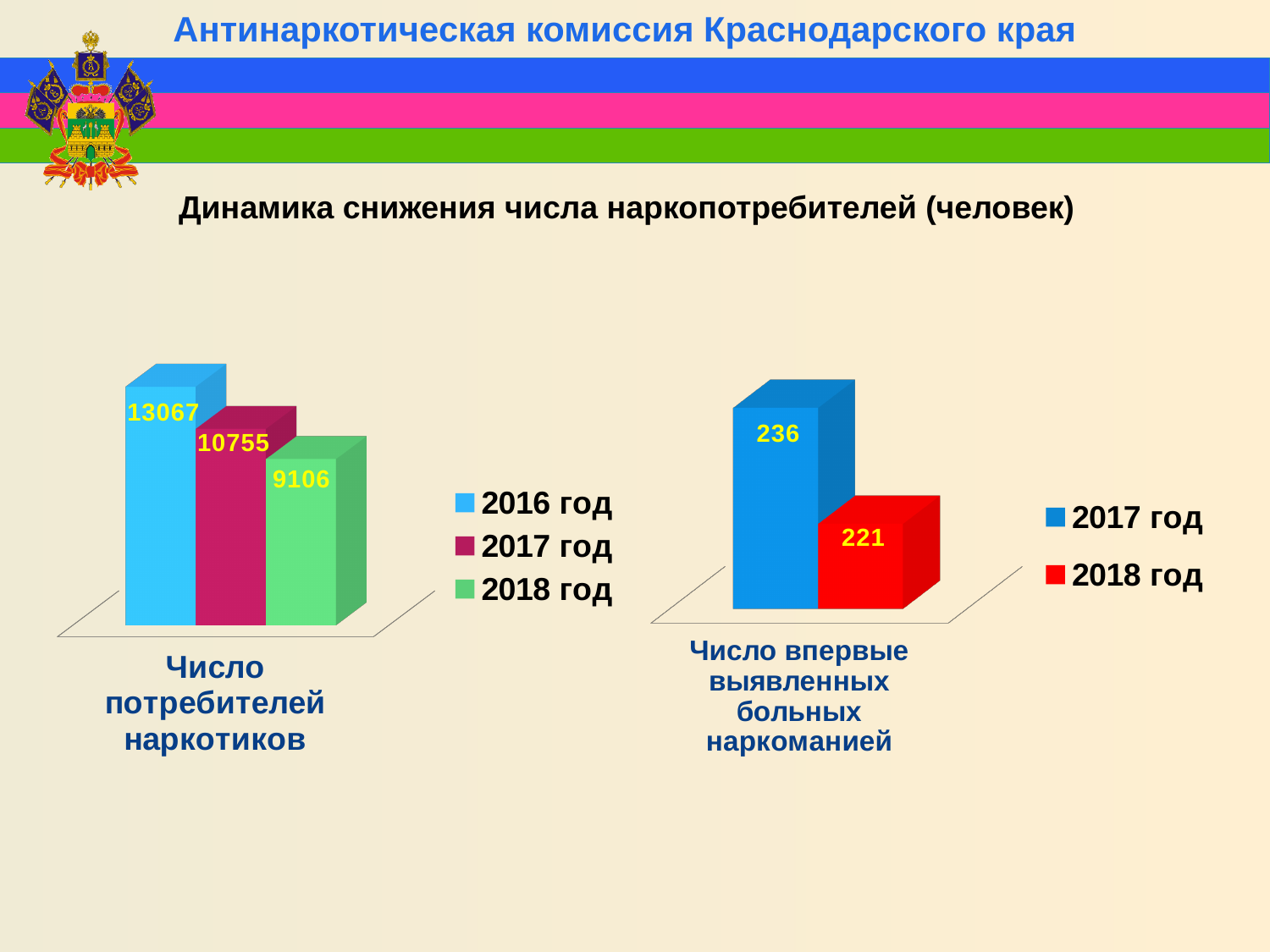
In the right chart (Число впервые выявленных больных наркоманией), what is the value for 2018 год? 221 What kind of chart is the right chart (Число впервые выявленных больных наркоманией)? Bar chart In the right chart (Число впервые выявленных больных наркоманией), what is the difference between the 2017 год and 2018 год values? 15 In the left chart (Число потребителей наркотиков), what is the difference between the 2016 год and 2017 год values? 2312 In the right chart (Число впервые выявленных больных наркоманией), which is larger, the value for 2017 год or 2018 год? 2017 год In the left chart (Число потребителей наркотиков), what is the value for 2018 год? 9106 In the right chart (Число впервые выявленных больных наркоманией), what is the value for 2017 год? 236 In the left chart (Число потребителей наркотиков), do the values rise or fall from 2016 год to 2018 год? Fall In the left chart (Число потребителей наркотиков), which year has the lowest value? 2018 год How many series does the legend of the left chart (Число потребителей наркотиков) list? 3 In the left chart (Число потребителей наркотиков), which year has the highest value? 2016 год In the left chart (Число потребителей наркотиков), what is the value for 2016 год? 13067